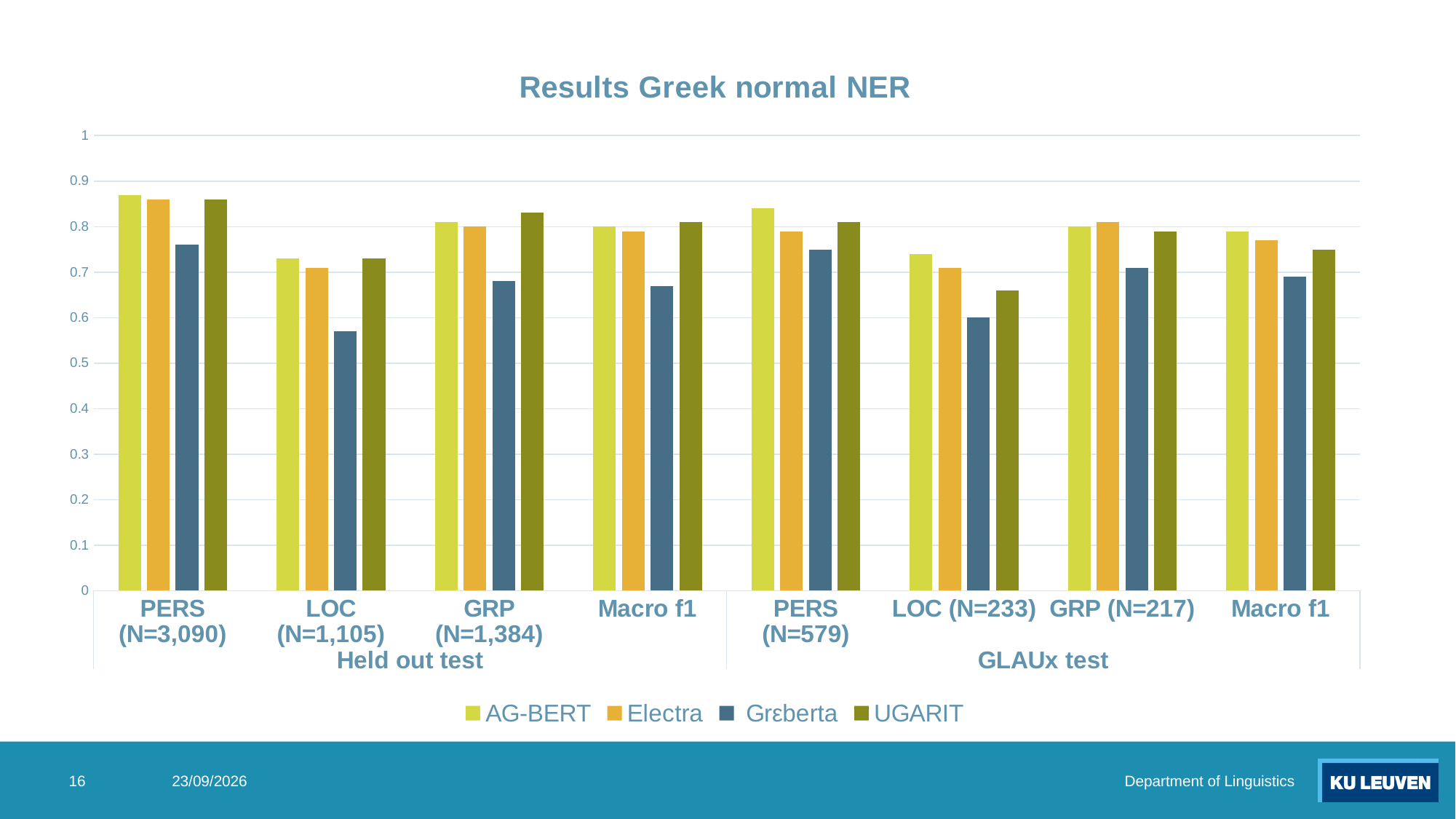
Which is larger: the UGARIT value for GRP (N=1,384) in the Held out test or the UGARIT value for GRP (N=217) in the GLAUx test? GRP (N=1,384) in the Held out test Which series has the lowest value for PERS (N=3,090) in the Held out test? Grεberta Which series is shown in dark blue in the legend? Grεberta What is the title of the chart? Results Greek normal NER How many category groups are shown along the x axis? 8 Which is larger: the Grεberta value for PERS (N=3,090) in the Held out test or the Grεberta value for LOC (N=1,105) in the Held out test? PERS (N=3,090) Is the value for Grεberta on Macro f1 in the Held out test greater or less than 0.7? less Which series has the lowest value for LOC (N=233) in the GLAUx test? Grεberta How many series does the legend list? 4 Is the value for AG-BERT on PERS (N=3,090) in the Held out test greater or less than 0.8? greater Is the value for Grεberta on LOC (N=1,105) in the Held out test greater or less than 0.6? less What kind of chart is shown on the slide? bar chart